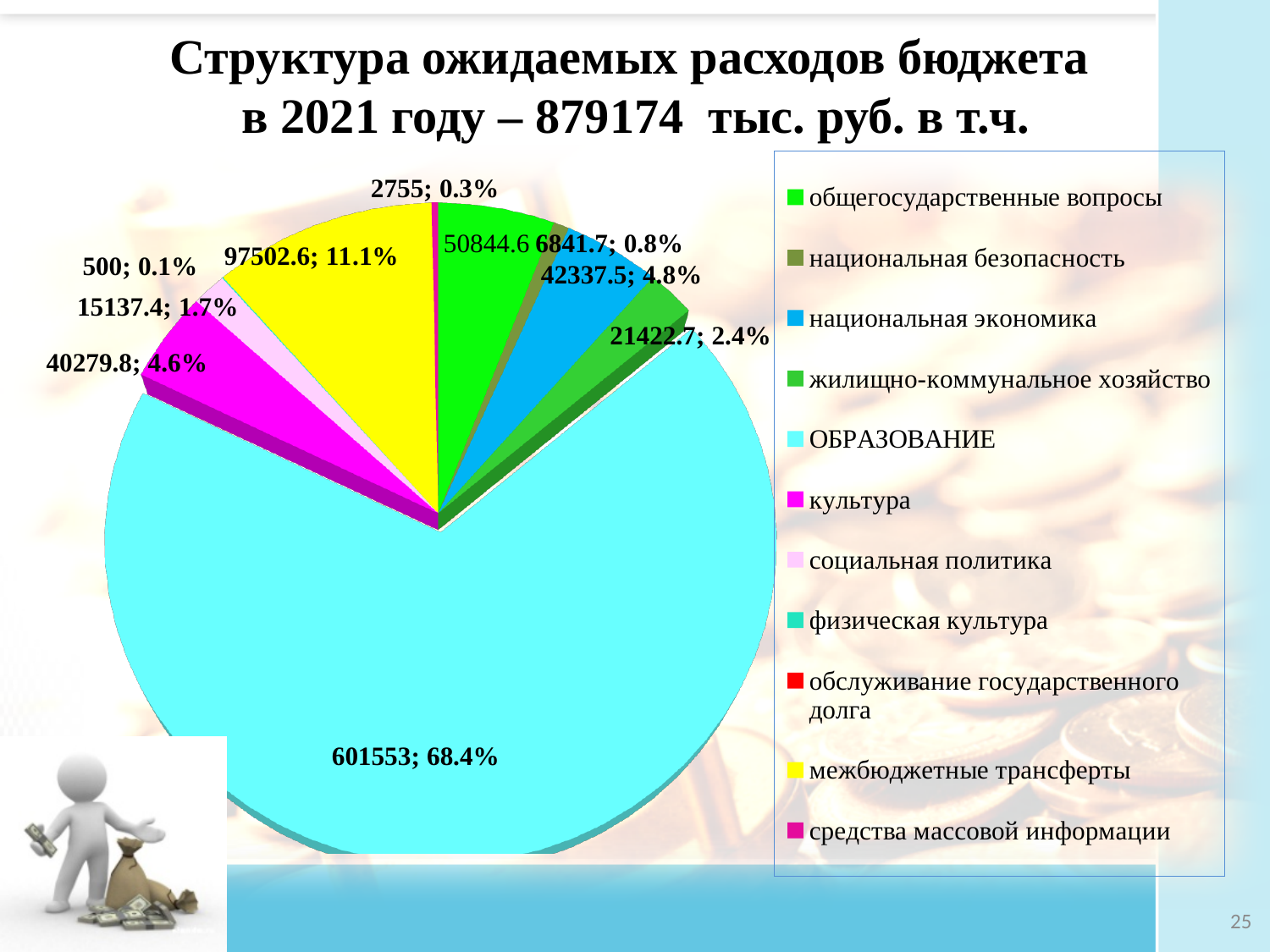
What total amount of expected budget expenditure for 2021 is stated in the chart title? 879174 тыс. руб. Which is larger, the value for национальная экономика or the value for культура? национальная экономика What percentage is shown for национальная экономика? 4.8% What share of the pie does ОБРАЗОВАНИЕ take? 68.4% What value is shown for the ОБРАЗОВАНИЕ slice? 601553 Which category has the largest slice of the pie? ОБРАЗОВАНИЕ How many categories does the legend list? 11 What kind of chart is shown on the slide? pie chart What value is shown for межбюджетные трансферты? 97502.6 What percentage is shown for социальная политика? 1.7% What value is shown for культура? 40279.8 What is the difference between the values for национальная экономика and культура? 2057.7